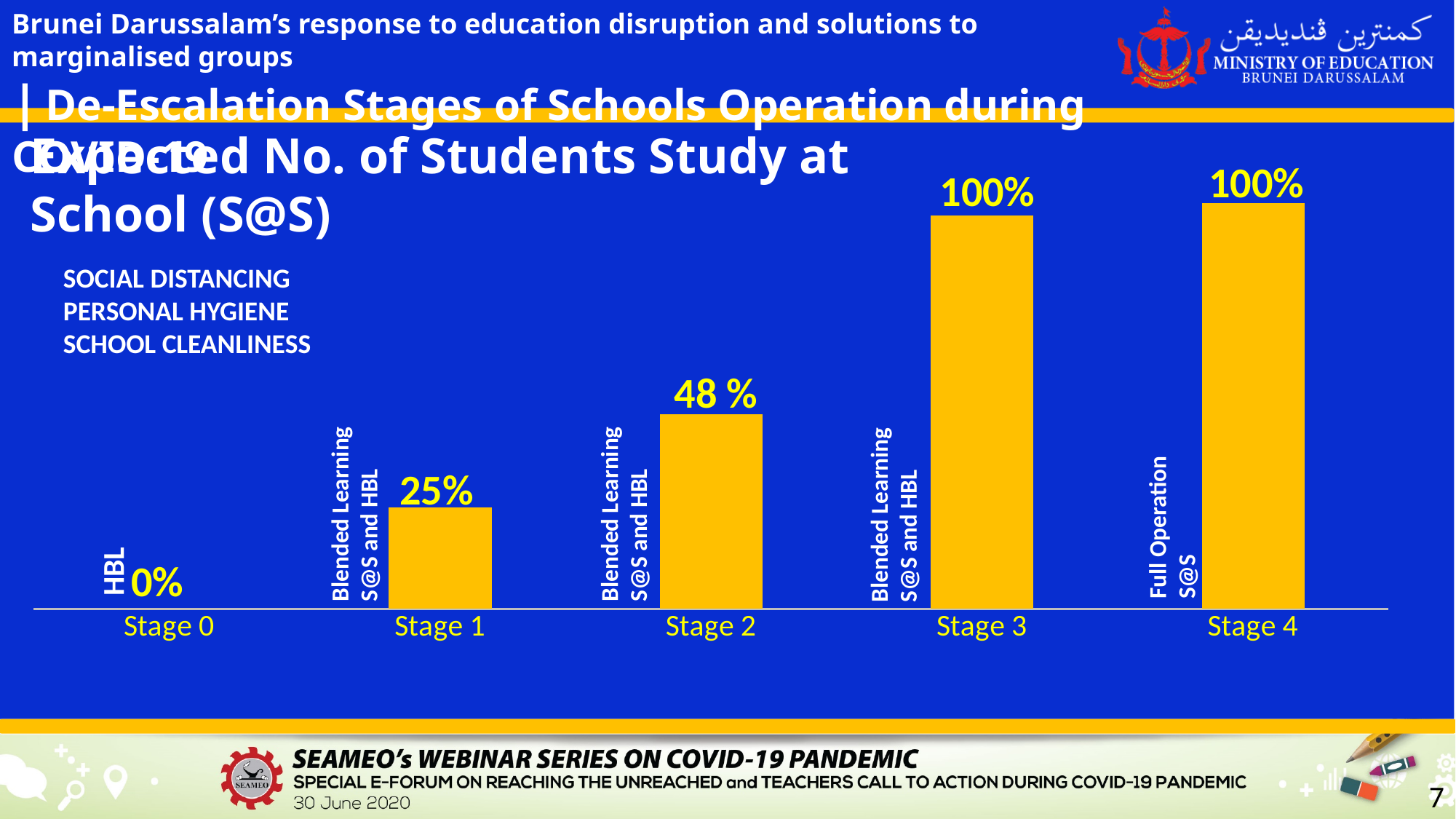
Do the values rise or fall from Stage 0 to Stage 3? Rise What is the value for Stage 1? 25% What is the value for Stage 3? 100% Which stage has the lowest value? Stage 0 What is the difference between the values for Stage 3 and Stage 2? 52% What is the difference between the values for Stage 2 and Stage 1? 23% What kind of chart is shown on the slide? Bar chart Which is larger, the value for Stage 1 or the value for Stage 2? Stage 2 What is the value for Stage 0? 0% What label is written beside the Stage 4 bar? Full Operation S@S How many stages are shown on the x axis? 5 What is the value for Stage 2? 48 %